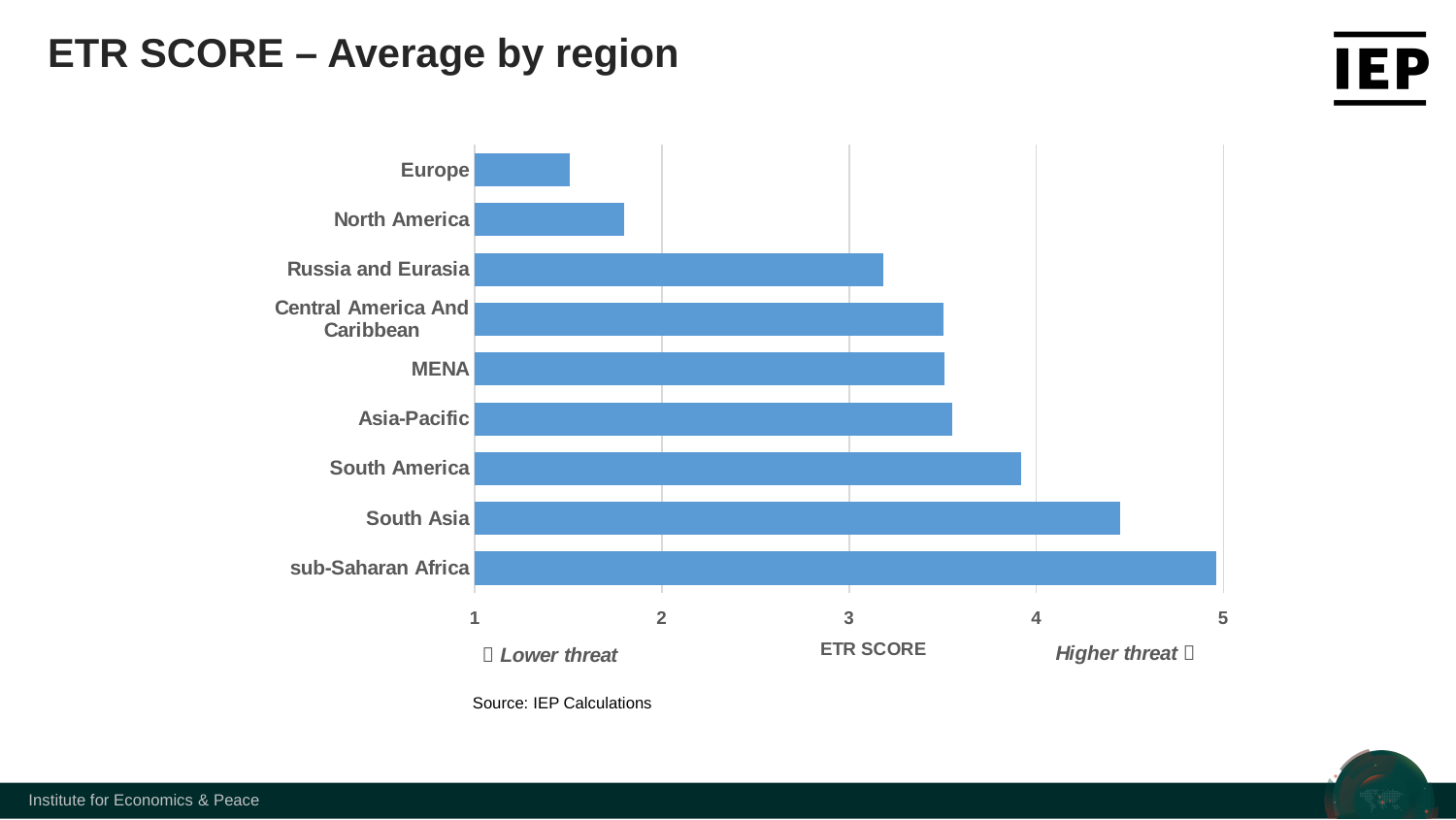
Is the value for sub-Saharan Africa greater or less than 4? greater What is the label on the horizontal axis of the chart? ETR SCORE Which region has the lowest average ETR score? Europe Which has a higher average ETR score, North America or Russia and Eurasia? Russia and Eurasia Which region has the highest average ETR score? sub-Saharan Africa Is the value for Europe greater or less than 2? less What kind of chart is shown on the slide? Bar chart Which has a higher average ETR score, South Asia or South America? South Asia Is the value for North America greater or less than 2? less How many regions are plotted in the chart? 9